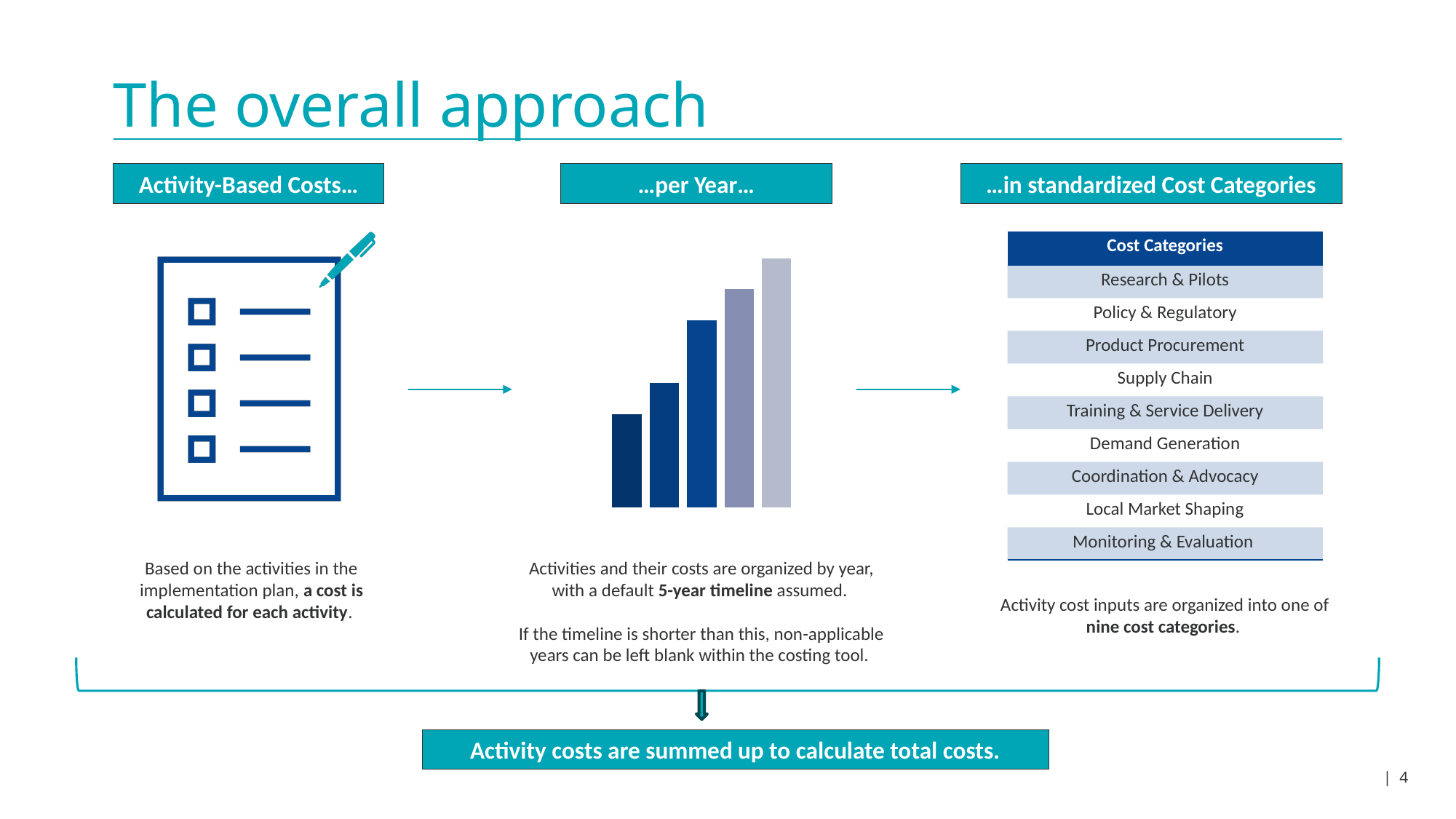
What kind of chart is shown in the middle panel under "...per Year..."? bar chart In the middle-panel bar chart, which bar is the tallest: the leftmost or the rightmost? the rightmost How many bars does the bar chart in the middle panel have? 5 Does the bar chart in the middle panel show any axis labels or data values? No Do the bars in the middle-panel bar chart rise or fall from left to right? rise